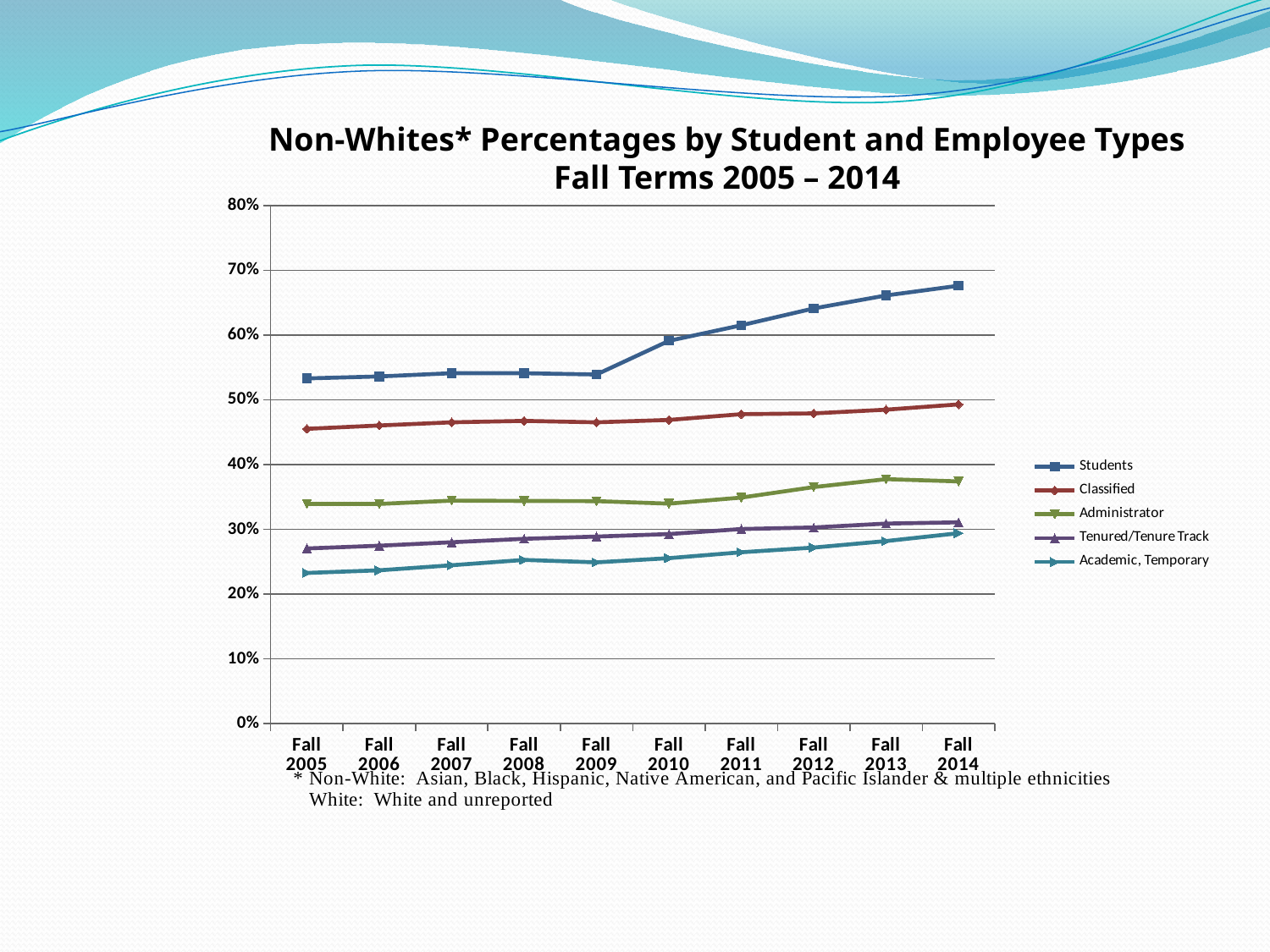
How many fall terms are plotted along the x axis? 10 How many series does the legend list? 5 Do the values for Students generally rise or fall from Fall 2005 to Fall 2014? rise Which series has the highest value in Fall 2014? Students Is the value for Administrator in Fall 2013 greater or less than 40%? less Is the value for Students in Fall 2014 greater or less than 60%? greater What is the title of the chart? Non-Whites* Percentages by Student and Employee Types Fall Terms 2005 – 2014 In Fall 2010, which is larger: the value for Students or the value for Classified? Students Is the value for Academic, Temporary in Fall 2005 greater or less than 20%? greater What kind of chart is shown on the slide? line chart Which series has the lowest value in Fall 2005? Academic, Temporary